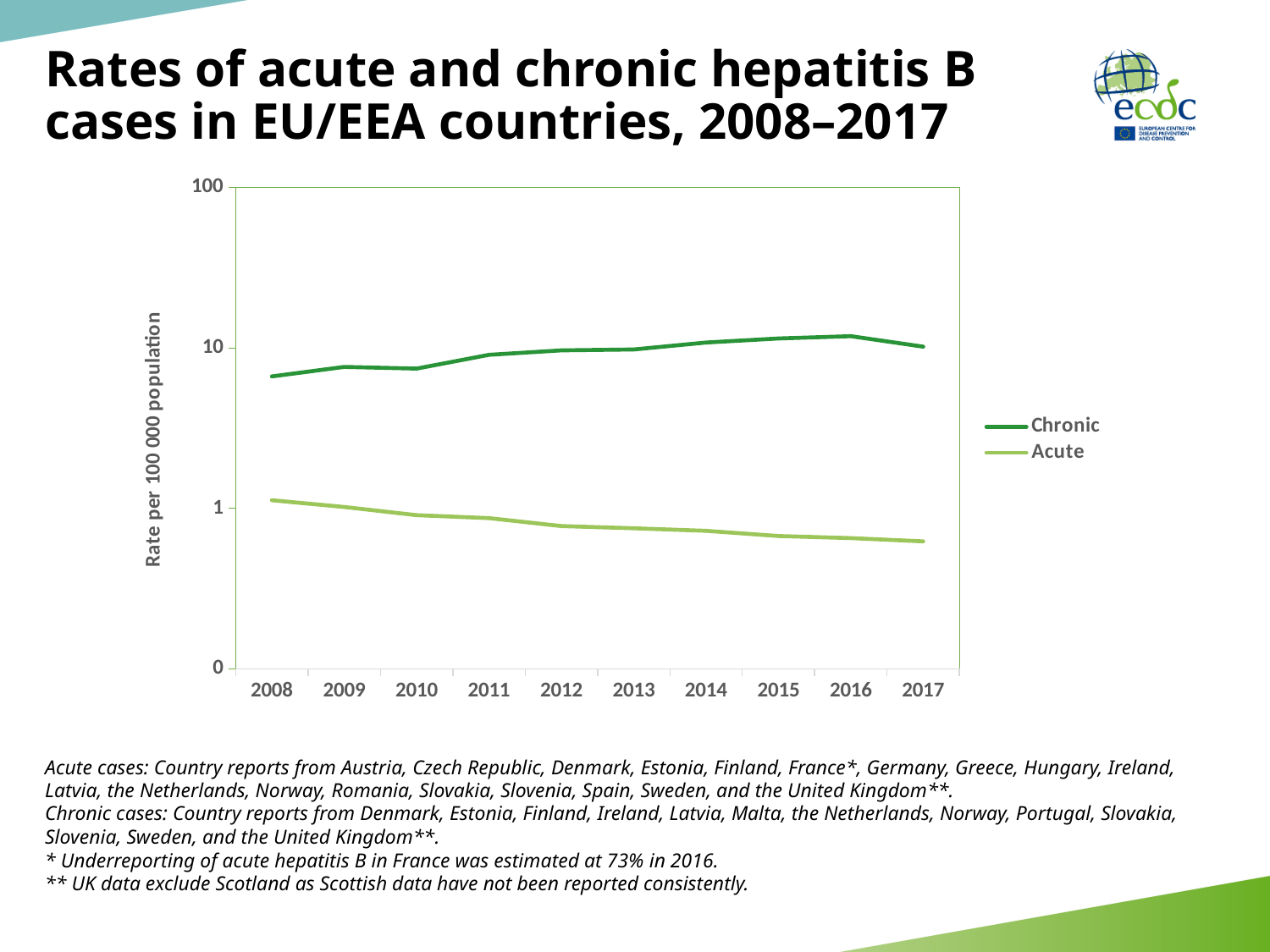
Is the Chronic rate in 2008 greater or less than 10? less In which year is the Chronic rate highest? 2016 In which year is the Chronic rate lowest? 2008 In which year is the Acute rate lowest? 2017 How many series does the legend list? 2 Is the Acute rate in 2017 greater or less than 1? less Does the Acute rate rise or fall from 2008 to 2017? Fall What kind of chart is shown on the slide? Line chart Does the Chronic rate rise or fall from 2008 to 2016? Rise How many years are plotted along the x axis? 10 In which year is the Acute rate highest? 2008 Which series has the higher rate in 2012, Chronic or Acute? Chronic